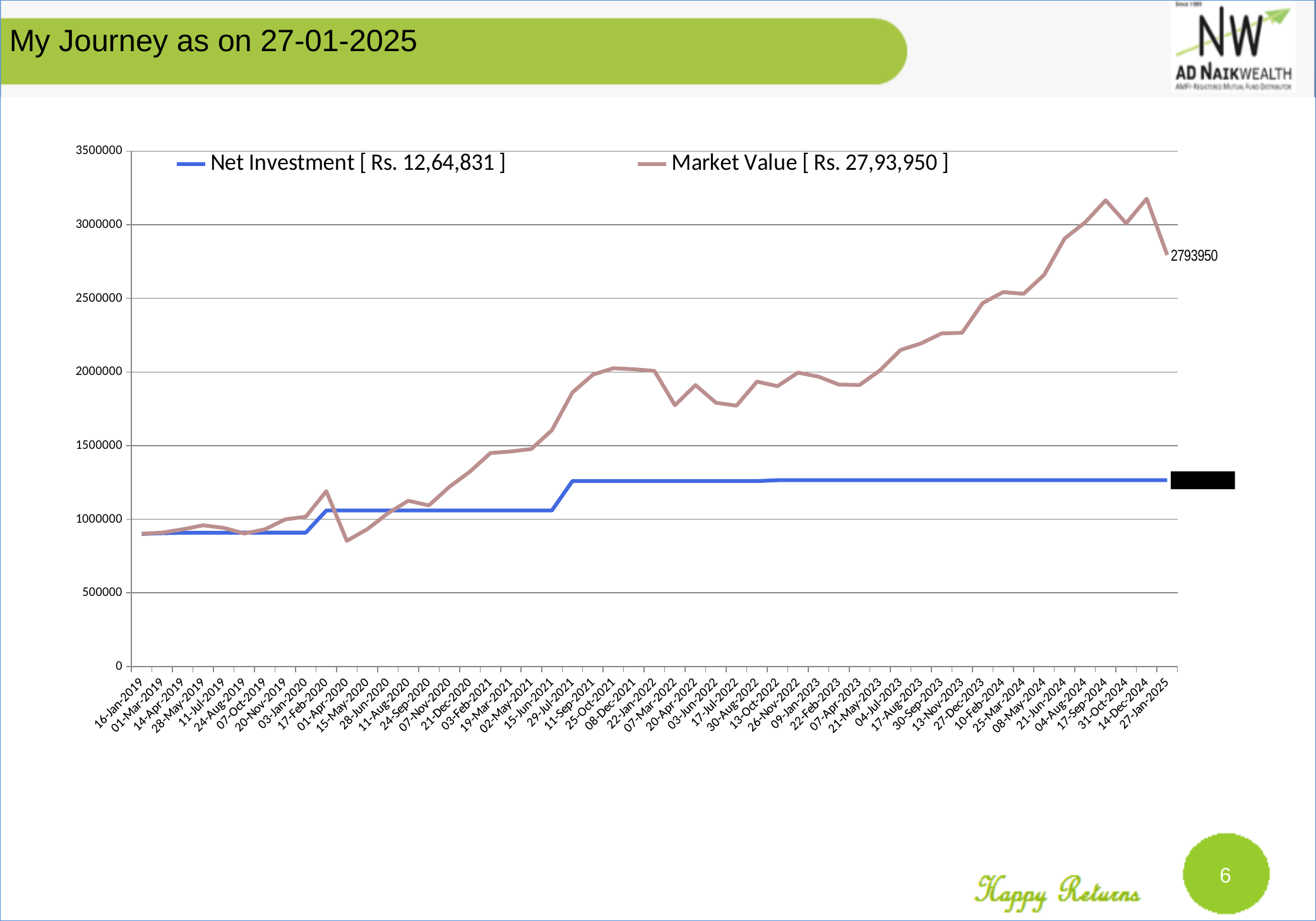
What is the Market Value on 27-Jan-2025 according to the data label? 2793950 Is the Market Value on 15-May-2020 greater or less than 1000000? less What Net Investment amount is shown in the legend entry? Rs. 12,64,831 Overall, does the Market Value line rise or fall from 16-Jan-2019 to 27-Jan-2025? rise On 27-Jan-2025, which is larger: Market Value or Net Investment? Market Value Is the Net Investment on 27-Jan-2025 greater or less than 1500000? less What kind of chart is shown on the slide? line chart How many series does the legend list? 2 What Market Value amount is shown in the legend entry? Rs. 27,93,950 Is the Market Value on 17-Sep-2024 greater or less than 3000000? greater